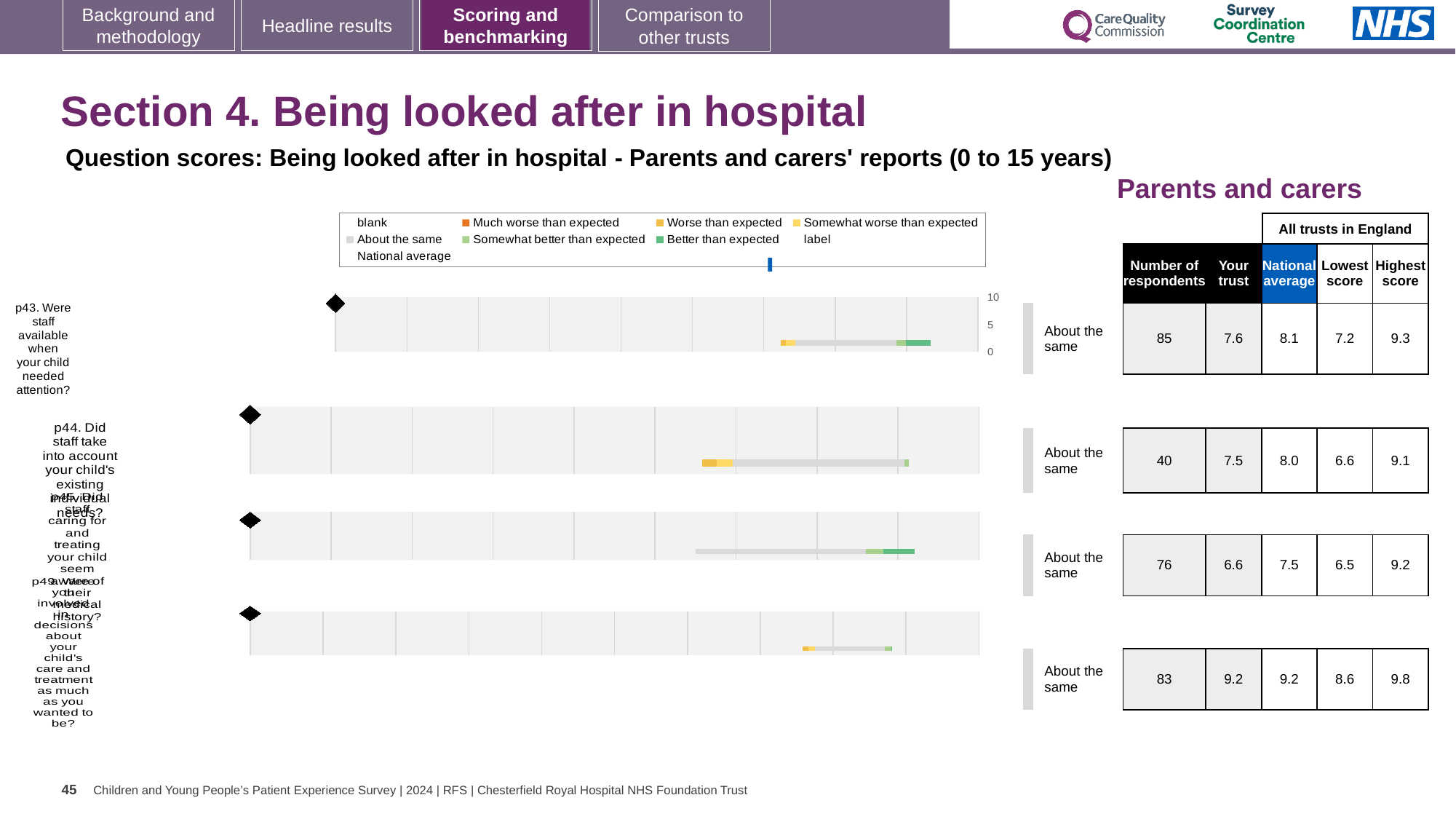
How many question rows (bar charts) are shown on the slide? 4 Which of the four question rows has the lowest number of respondents? p44 (second row), 40 For the fourth chart from the top, what is the lowest score across all trusts in England? 8.6 In the legend, what colour represents 'Better than expected'? Green For the first chart (p43), what is the difference between the national average and the 'Your trust' score? 0.5 For the second chart (p44, Did staff take into account your child's existing individual needs?), what is the highest score across all trusts in England? 9.1 For the first chart (p43), what is the national average score shown in the table? 8.1 For the first chart (p43), what is the number of respondents? 85 What kind of chart is used to show the question scores on this slide? bar chart Which of the four question rows has the highest 'Your trust' score? The fourth row (p49), 9.2 For the third chart from the top, which is larger: the 'Your trust' score or the national average? National average For the first chart (p43, Were staff available when your child needed attention?), what is the 'Your trust' score shown in the table? 7.6